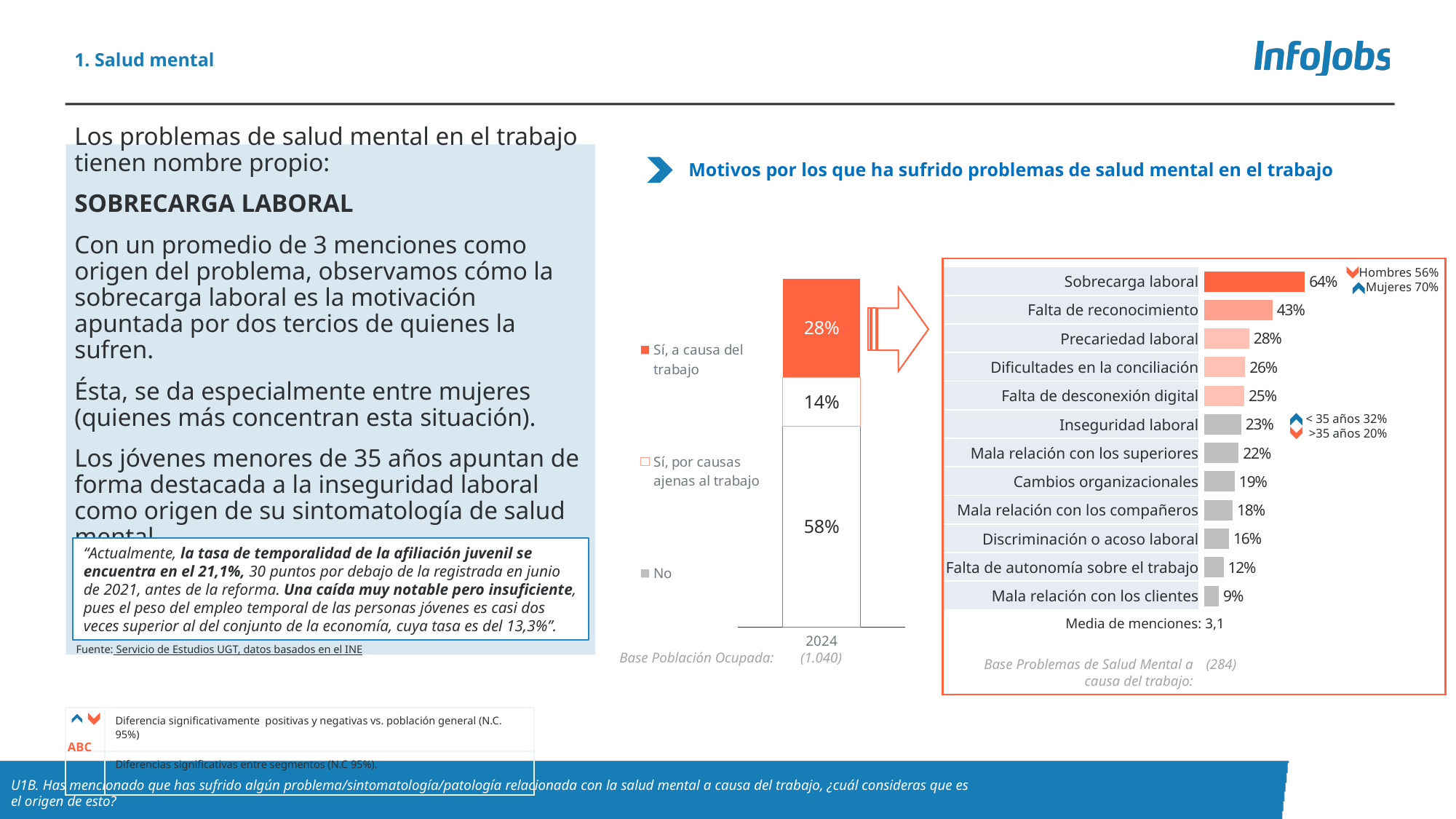
In the stacked bar chart on the left, how many series does the legend list? 3 In the 'Motivos por los que ha sufrido problemas de salud mental en el trabajo' chart, what is the value for 'Falta de desconexión digital'? 25% In the stacked bar chart on the left, what is the total of the three segments of the 2024 bar? 100% In the stacked bar chart on the left, what percentage corresponds to 'No' for 2024? 58% In the 'Motivos por los que ha sufrido problemas de salud mental en el trabajo' chart, which category has the highest value? Sobrecarga laboral In the stacked bar chart on the left, what percentage corresponds to 'Sí, a causa del trabajo' for 2024? 28% In the 'Motivos por los que ha sufrido problemas de salud mental en el trabajo' chart, what is the difference between 'Sobrecarga laboral' and 'Falta de reconocimiento'? 21% In the 'Motivos por los que ha sufrido problemas de salud mental en el trabajo' chart, what is the value for 'Sobrecarga laboral'? 64% In the 'Motivos por los que ha sufrido problemas de salud mental en el trabajo' chart, which is larger: 'Cambios organizacionales' or 'Discriminación o acoso laboral'? Cambios organizacionales In the 'Motivos por los que ha sufrido problemas de salud mental en el trabajo' chart, which category has the lowest value? Mala relación con los clientes How many categories are shown in the 'Motivos por los que ha sufrido problemas de salud mental en el trabajo' chart? 12 What kind of chart is the 'Motivos por los que ha sufrido problemas de salud mental en el trabajo' chart? Bar chart